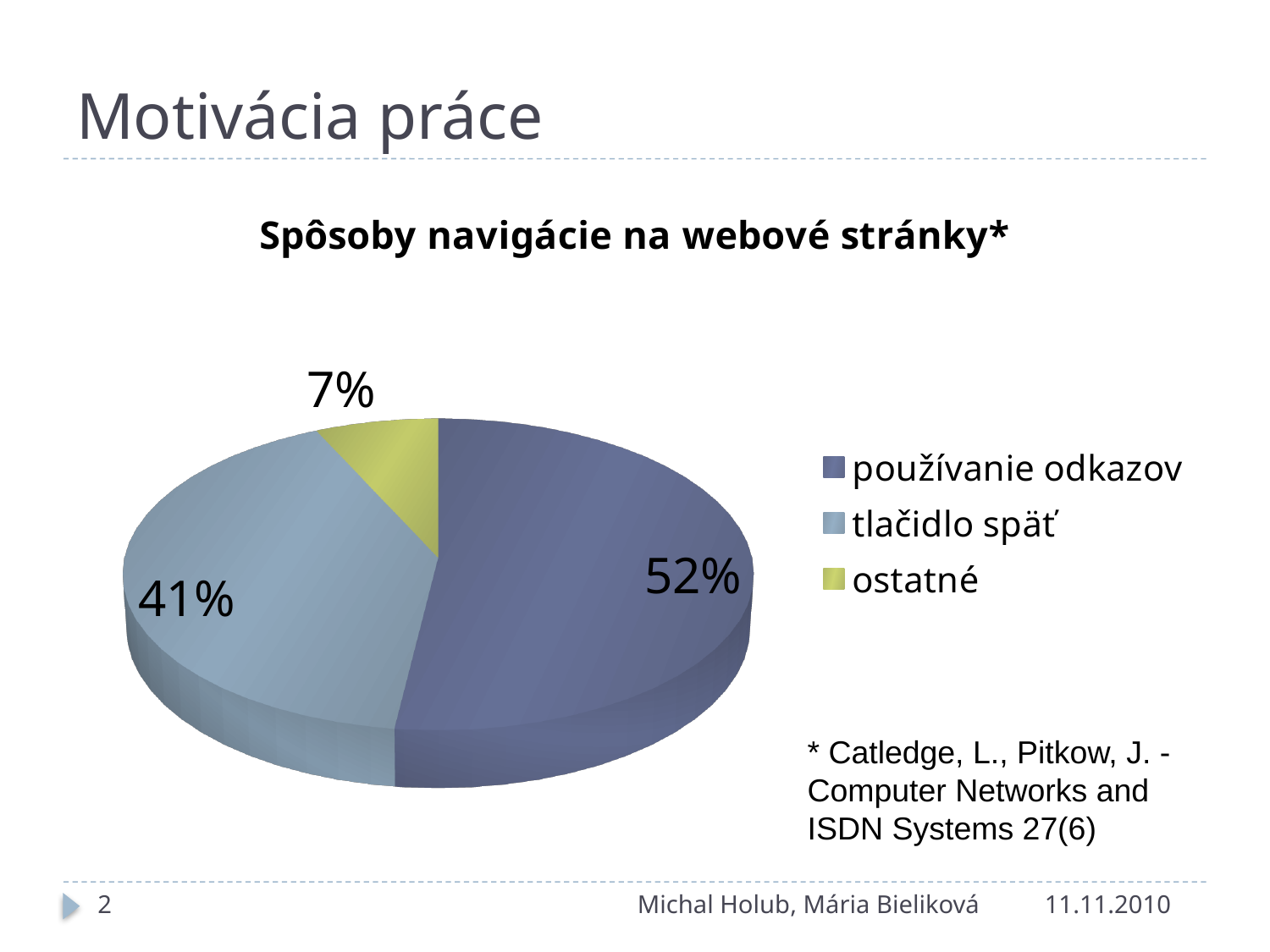
How many categories does the pie chart have? 3 Which is larger, the slice for 'tlačidlo späť' or the slice for 'ostatné'? tlačidlo späť What is the difference in percentage points between 'používanie odkazov' and 'tlačidlo späť'? 11 What kind of chart is shown on the slide? pie chart What share of the pie does 'ostatné' have? 7% Which category has the smallest slice of the pie? ostatné Which category has the largest slice of the pie? používanie odkazov How many entries does the legend list? 3 What is the difference in percentage points between 'tlačidlo späť' and 'ostatné'? 34 What share of the pie does 'tlačidlo späť' have? 41% What is the title of the chart? Spôsoby navigácie na webové stránky* What share of the pie does 'používanie odkazov' have? 52%